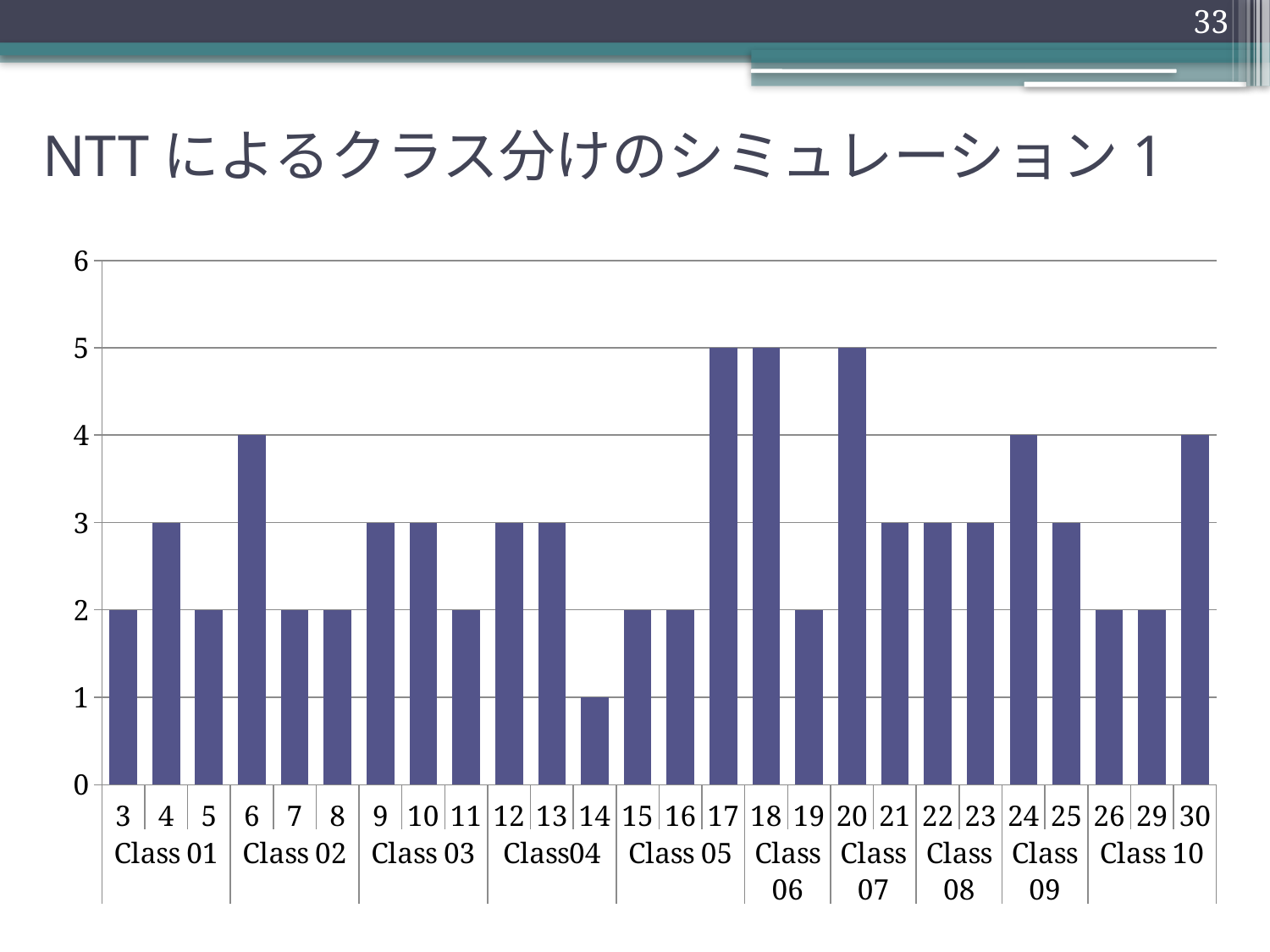
What is the value for category 6 (Class 02)? 4 What is the difference between the values for category 18 and category 19? 3 Which has the larger value, category 24 or category 25? 24 What is the highest value reached by any bar? 5 Which category has the lowest value? 14 How many bars are plotted in the chart? 26 What is the value for category 17 (Class 05)? 5 Is the value for category 20 greater or less than 4? greater What kind of chart is shown on the slide? bar chart What is the value for category 30 (Class 10)? 4 What is the value for category 14 (Class04)? 1 How many class groups are labelled along the x axis? 10